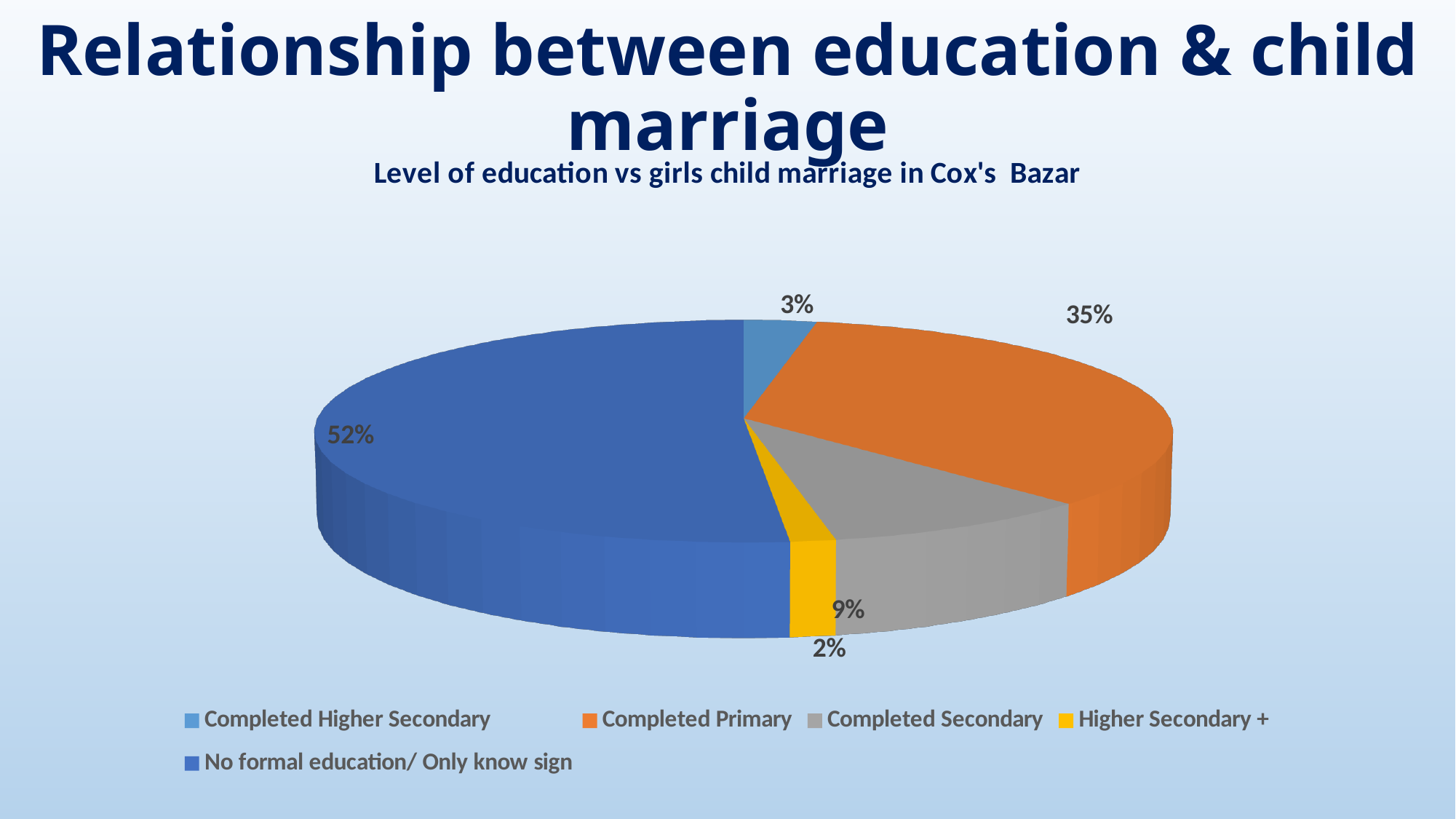
What percentage is shown for Completed Secondary? 9% What percentage is shown for Completed Primary? 35% Which is larger, the share for Completed Secondary or the share for Completed Higher Secondary? Completed Secondary Which category has the largest share of the pie? No formal education/ Only know sign What percentage is shown for Higher Secondary +? 2% How many slices does the pie chart have? 5 What percentage is shown for No formal education/ Only know sign? 52% Which category has the smallest share of the pie? Higher Secondary + What is the chart's title? Level of education vs girls child marriage in Cox's Bazar What is the difference in percentage points between No formal education/ Only know sign and Completed Primary? 17 What kind of chart is shown on the slide? Pie chart What percentage is shown for Completed Higher Secondary? 3%